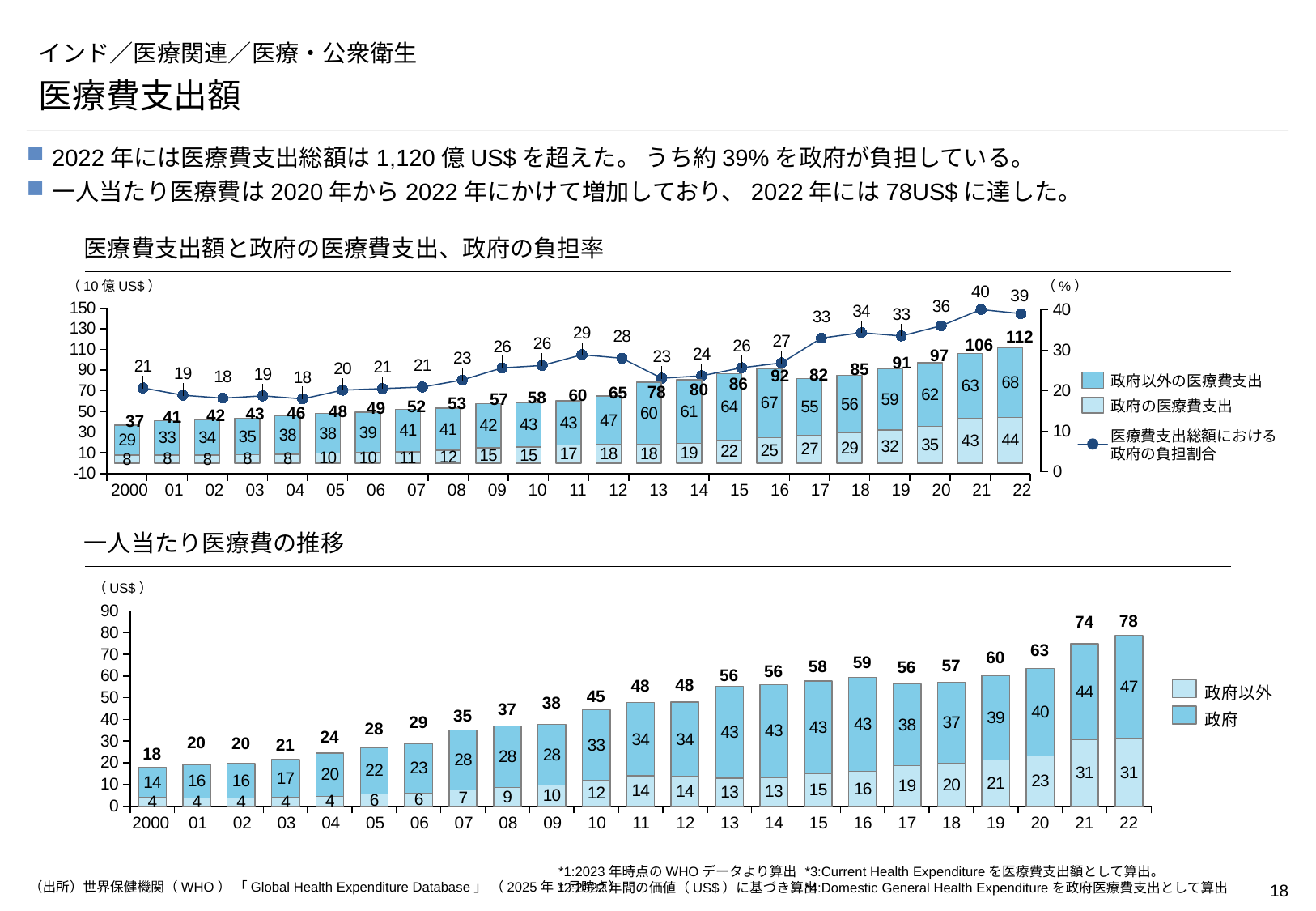
In the top chart, what is the 政府の負担割合 (government share) value for 2021? 40 In the top chart (医療費支出額と政府の医療費支出、政府の負担率), what is the total health expenditure for 2022? 112 In the bottom chart (一人当たり医療費の推移), which year has the lowest total per-capita health expenditure? 2000 How many series does the legend of the top chart list? 3 In the top chart, what is the difference between the total health expenditure in 2022 and in 2021? 6 In the bottom chart (一人当たり医療費の推移), which year has the larger total: 2012 or 2013? 2013 In the bottom chart (一人当たり医療費の推移), what is the total per-capita health expenditure for 2022? 78 In the top chart, what is the 政府の医療費支出 value for 2016? 25 How many years (bars) are shown in the bottom chart (一人当たり医療費の推移)? 23 In the top chart, what is the 政府以外の医療費支出 value for 2013? 60 What kind of chart is the top chart titled 医療費支出額と政府の医療費支出、政府の負担率? A stacked bar chart combined with a line In the top chart, which year has the highest total health expenditure? 22 (2022)